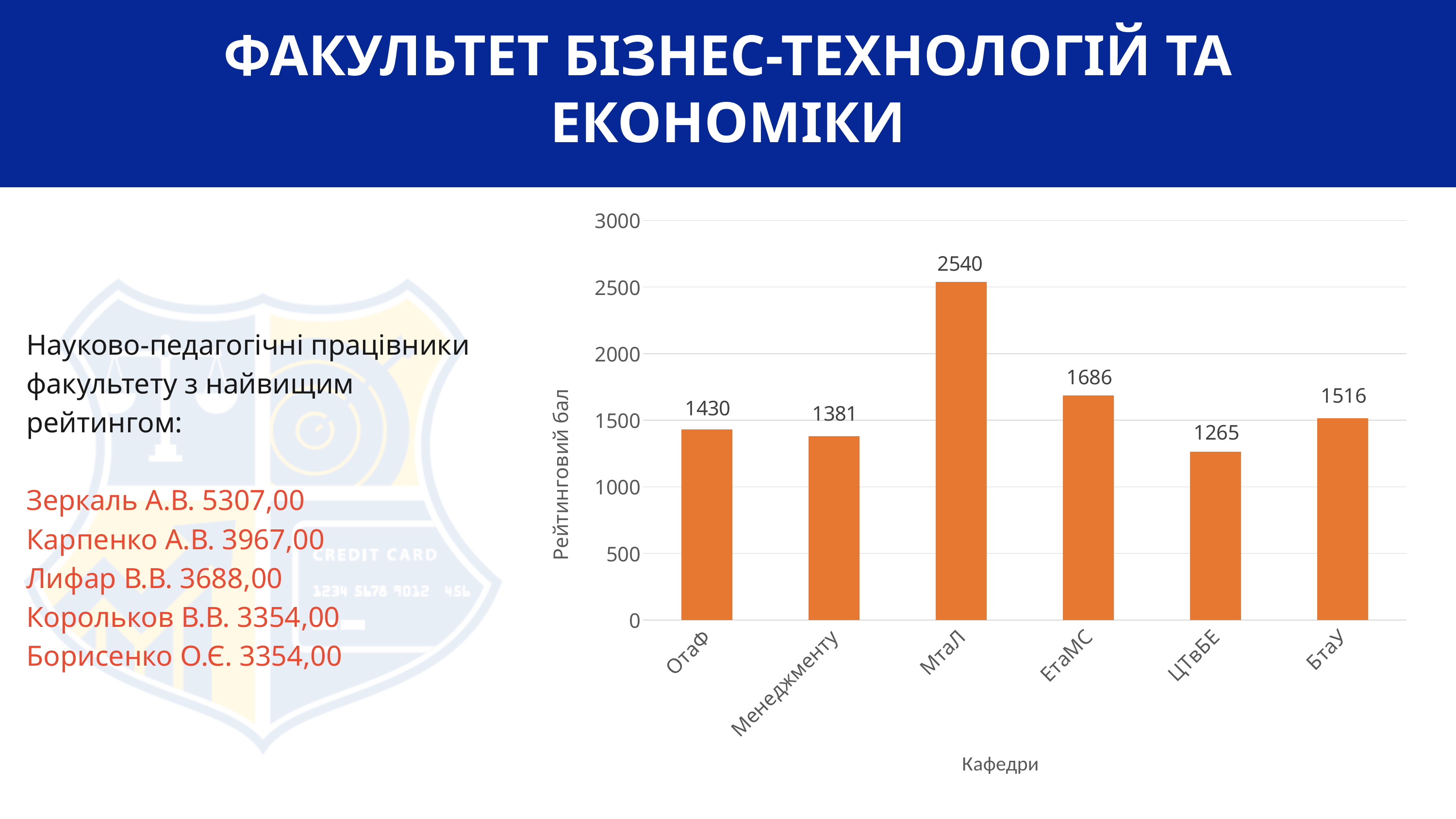
Which has a higher value, БтаУ or ЦТвБЕ? БтаУ What is the rating score (Рейтинговий бал) for the МтаЛ department? 2540 What is the difference between the values for ОтаФ and Менеджменту? 49 What type of chart is shown on the slide? bar chart What is the value shown for the ЕтаМС department? 1686 What is the value shown for the Менеджменту department? 1381 Which department has the lowest rating score? ЦТвБЕ What is the label of the vertical axis of the chart? Рейтинговий бал Is the value for ЕтаМС greater or less than 1500? greater Which department has the highest rating score? МтаЛ What is the difference between the values for МтаЛ and ЕтаМС? 854 How many departments are shown on the x axis of the chart? 6